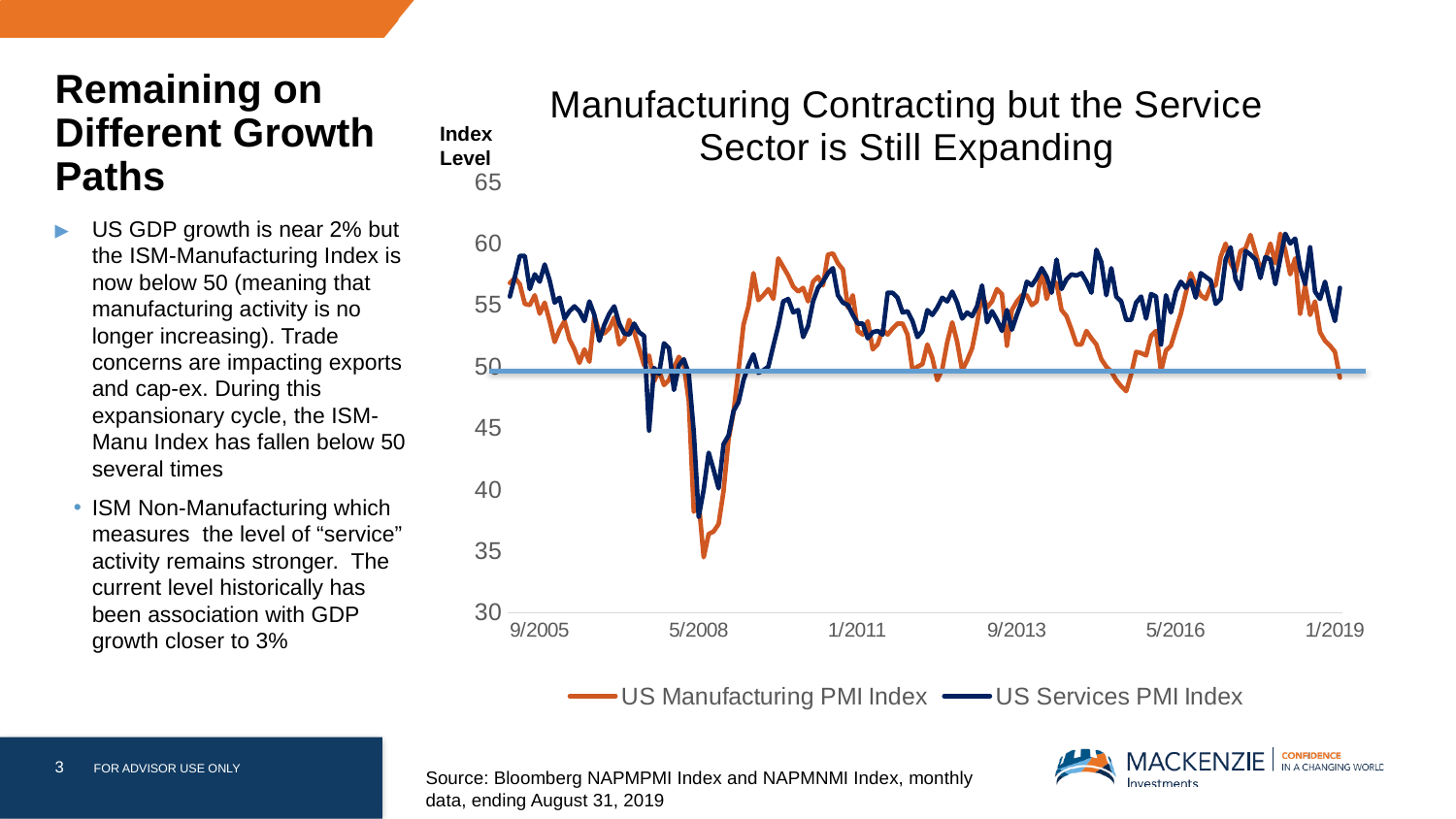
Is the lowest value of the US Services PMI Index around 2008-2009 greater or less than 45? less Which series fell to a lower minimum during the 2008-2009 downturn, US Manufacturing PMI Index or US Services PMI Index? US Manufacturing PMI Index What is the title of the chart? Manufacturing Contracting but the Service Sector is Still Expanding Is the value of the US Services PMI Index at the end of the series (2019) greater or less than 50? greater What is the lowest value shown on the y axis of the chart? 30 Is the lowest value of the US Manufacturing PMI Index around 2008-2009 greater or less than 40? less How many date labels are shown on the x axis of the chart? 6 Which series is drawn in orange in the chart? US Manufacturing PMI Index What is the highest value shown on the y axis of the chart? 65 At what index level is the horizontal reference line drawn across the chart? 50 How many series does the chart legend list? 2 What kind of chart is shown on the slide? Line chart